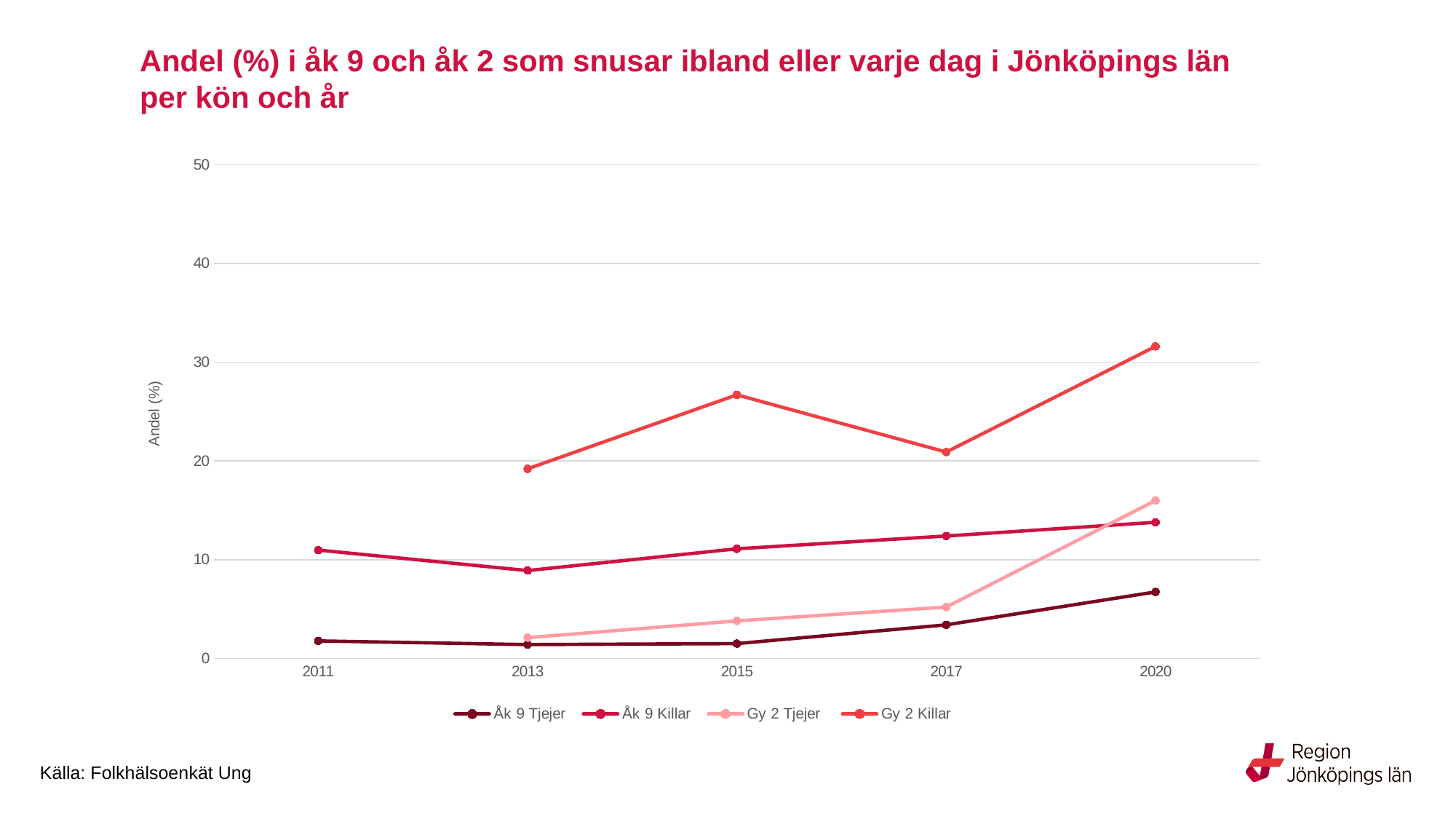
Which series has the lowest value in 2013? Åk 9 Tjejer Does the Åk 9 Tjejer line rise or fall between 2013 and 2020? Rise Which is larger for Gy 2 Killar: the value in 2015 or the value in 2017? 2015 Which series has the highest value in 2020? Gy 2 Killar Is the value for Åk 9 Killar in 2013 greater or less than 10? less Is the value for Gy 2 Tjejer in 2020 greater or less than 10? greater Is the value for Gy 2 Killar in 2020 greater or less than 30? greater What is the label on the y axis? Andel (%) How many series does the legend list? 4 How many years are shown on the x axis? 5 What kind of chart is shown on the slide? Line chart